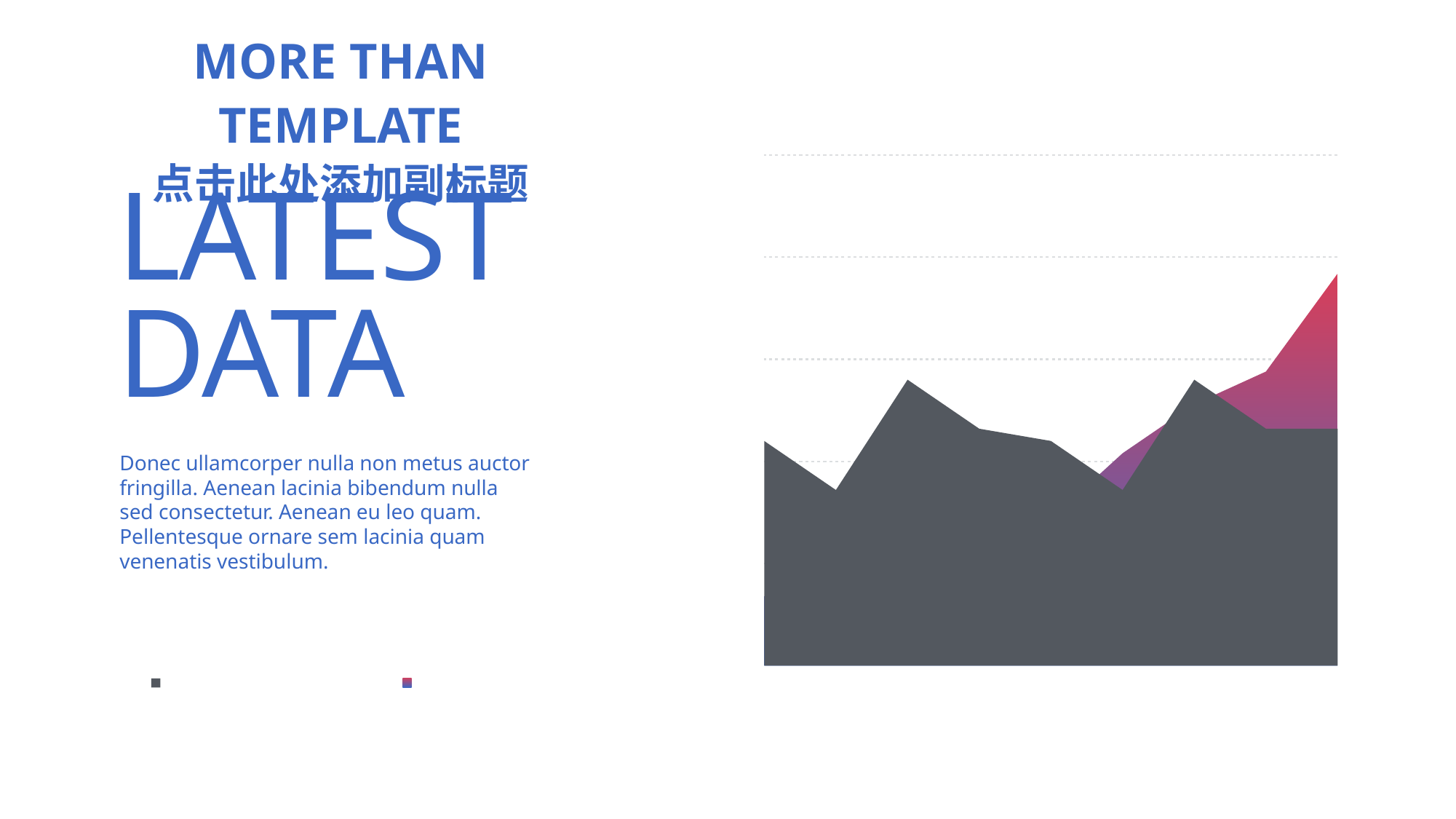
What kind of chart is shown on the slide? area chart Does the pink/red series rise or fall toward the right end of the chart? rise What colour is the larger filled area at the bottom of the chart? dark grey How many data points does the grey series have along the x axis? 9 How many series does the chart's legend show? 2 Does the chart display any numeric axis labels or data labels? No Which series reaches the highest point on the chart, the grey one or the pink/red one? the pink/red one